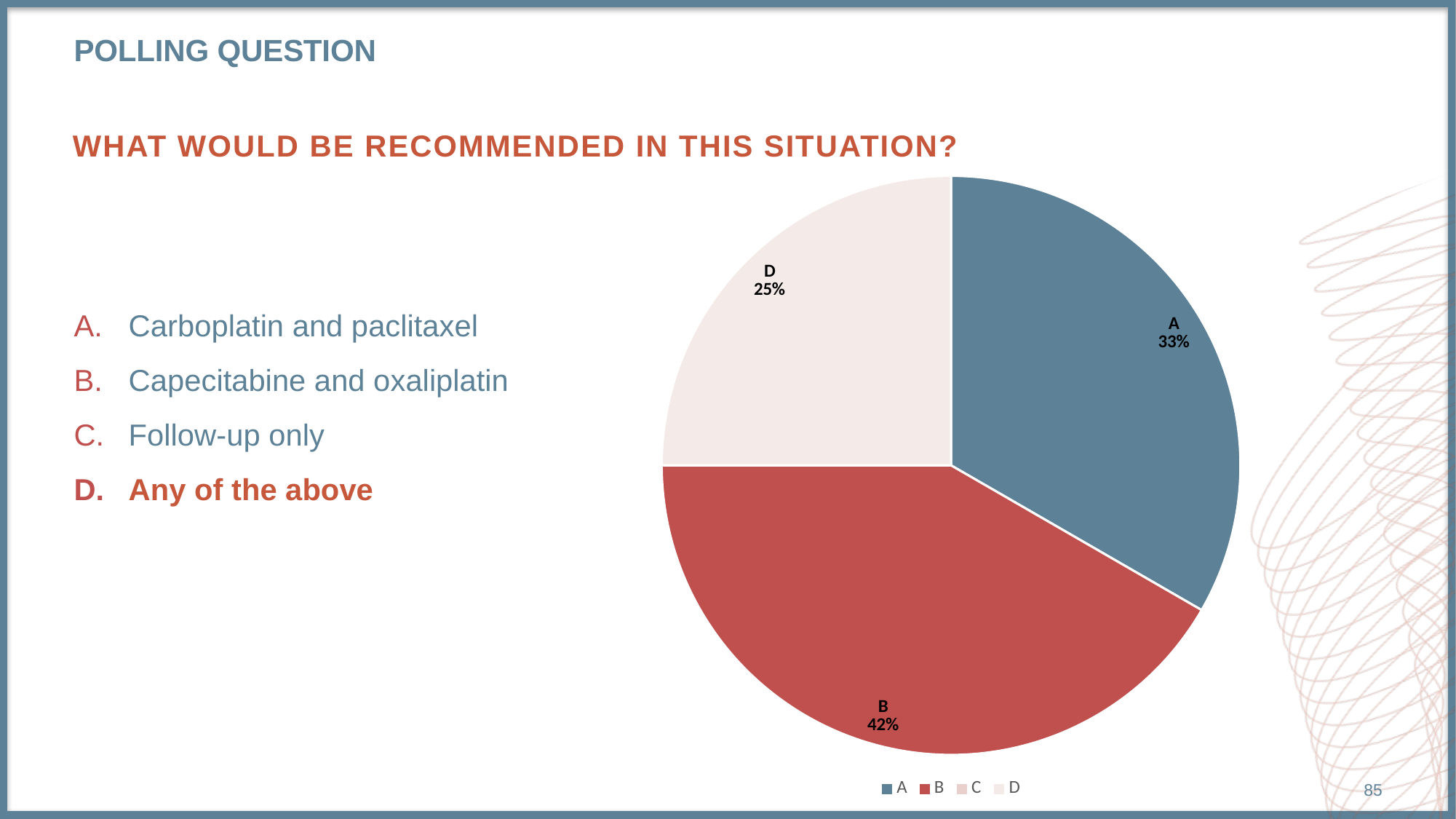
What percentage of the pie is labelled for option B? 42% How many slices have a percentage label printed on the pie? 3 What is the difference in percentage points between the shares for A and D? 8 Which option has the largest slice of the pie? B What percentage of the pie is labelled for option A? 33% How many entries does the legend list? 4 Which has the larger share, A or D? A What kind of chart is shown on the slide? pie chart What colour is the slice for option B? red What percentage of the pie is labelled for option D? 25% Of the slices with printed labels, which option has the smallest share? D What is the difference in percentage points between the shares for B and A? 9